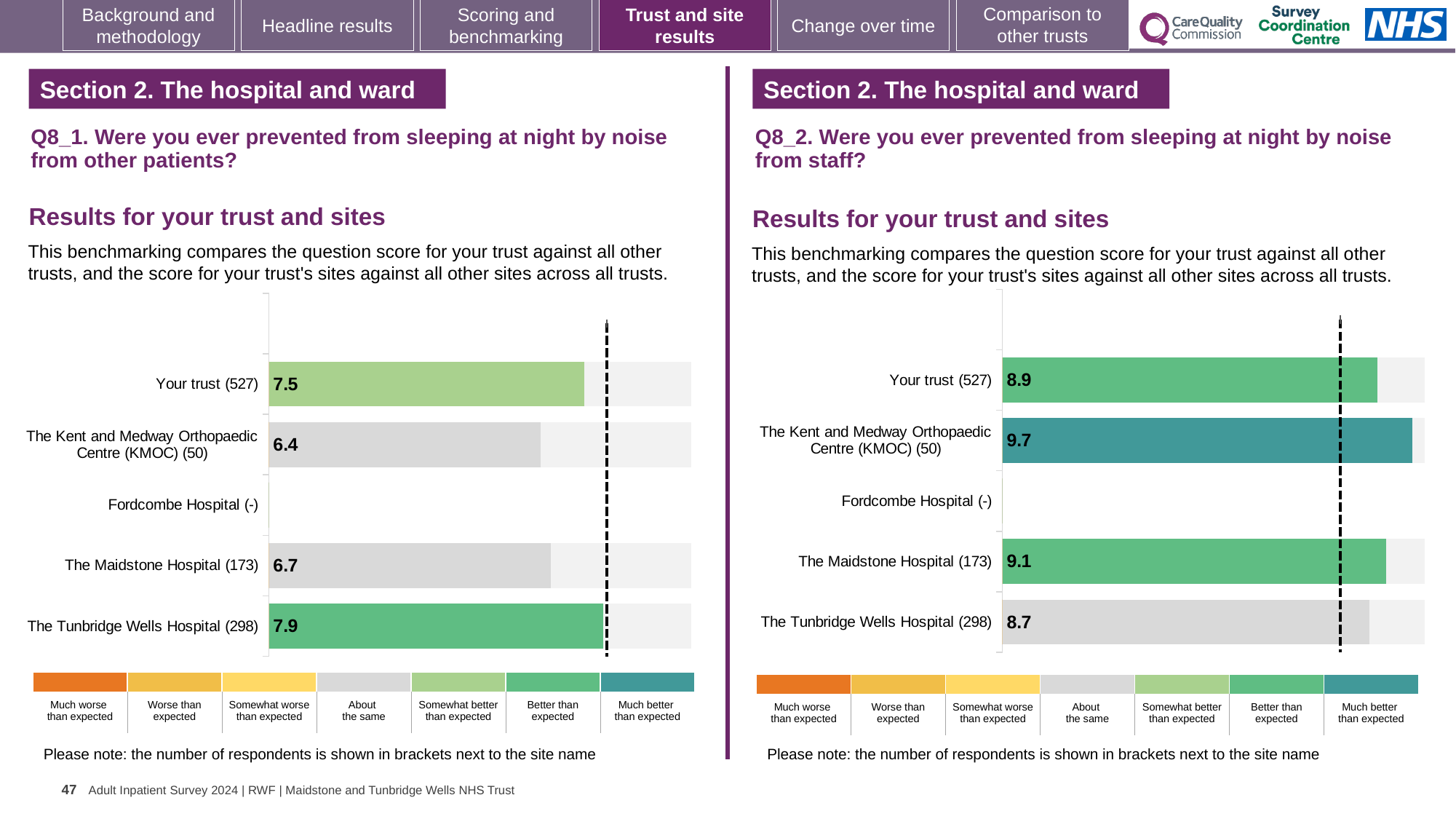
In the Q8_2 chart (noise from staff), which site has the lowest score? The Tunbridge Wells Hospital (298) In the Q8_1 chart (noise from other patients), what is the score for The Kent and Medway Orthopaedic Centre (KMOC) (50)? 6.4 In the Q8_2 chart (noise from staff), which is larger: the score for Your trust (527) or The Tunbridge Wells Hospital (298)? Your trust (527) In the Q8_1 chart (noise from other patients), which site has the highest score? The Tunbridge Wells Hospital (298) In the Q8_1 chart (noise from other patients), which site has the lowest score? The Kent and Medway Orthopaedic Centre (KMOC) (50) In the Q8_2 chart (noise from staff), which site has the highest score? The Kent and Medway Orthopaedic Centre (KMOC) (50) In the Q8_1 chart (noise from other patients), what is the difference between the scores for The Tunbridge Wells Hospital (298) and The Maidstone Hospital (173)? 1.2 In the Q8_2 chart (noise from staff), what is the difference between the scores for The Kent and Medway Orthopaedic Centre (KMOC) (50) and Your trust (527)? 0.8 How many sites or categories are listed on the y axis of the Q8_1 chart (noise from other patients)? 5 In the Q8_1 chart (noise from other patients), what is the score for Your trust (527)? 7.5 What type of chart is used for the Q8_2 results (noise from staff)? Bar chart In the Q8_2 chart (noise from staff), what is the score for The Maidstone Hospital (173)? 9.1